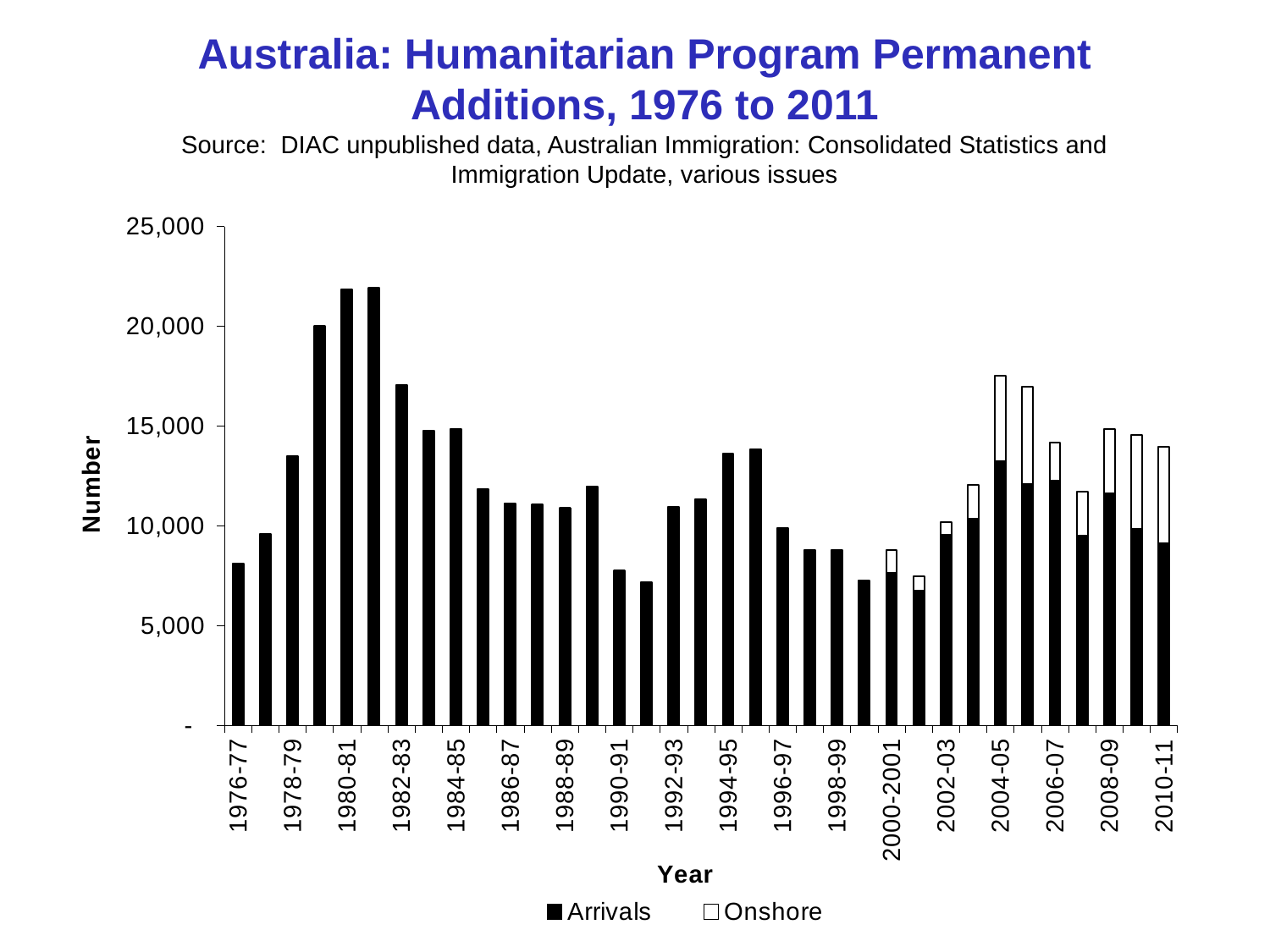
Is the Arrivals value for 1980-81 greater or less than 20,000? greater Is the Arrivals value for 1976-77 greater or less than 10,000? less What is the title of the y axis? Number How many series does the legend list? 2 What are the two series named in the legend? Arrivals and Onshore Which year has the larger Arrivals value, 1980-81 or 1976-77? 1980-81 Is the total stacked bar for 2004-05 greater or less than 15,000? greater Do the Arrivals values rise or fall from 1981-82 to 1990-91? fall Do the Arrivals values rise or fall from 1976-77 to 1980-81? rise What kind of chart is shown on the slide? bar chart